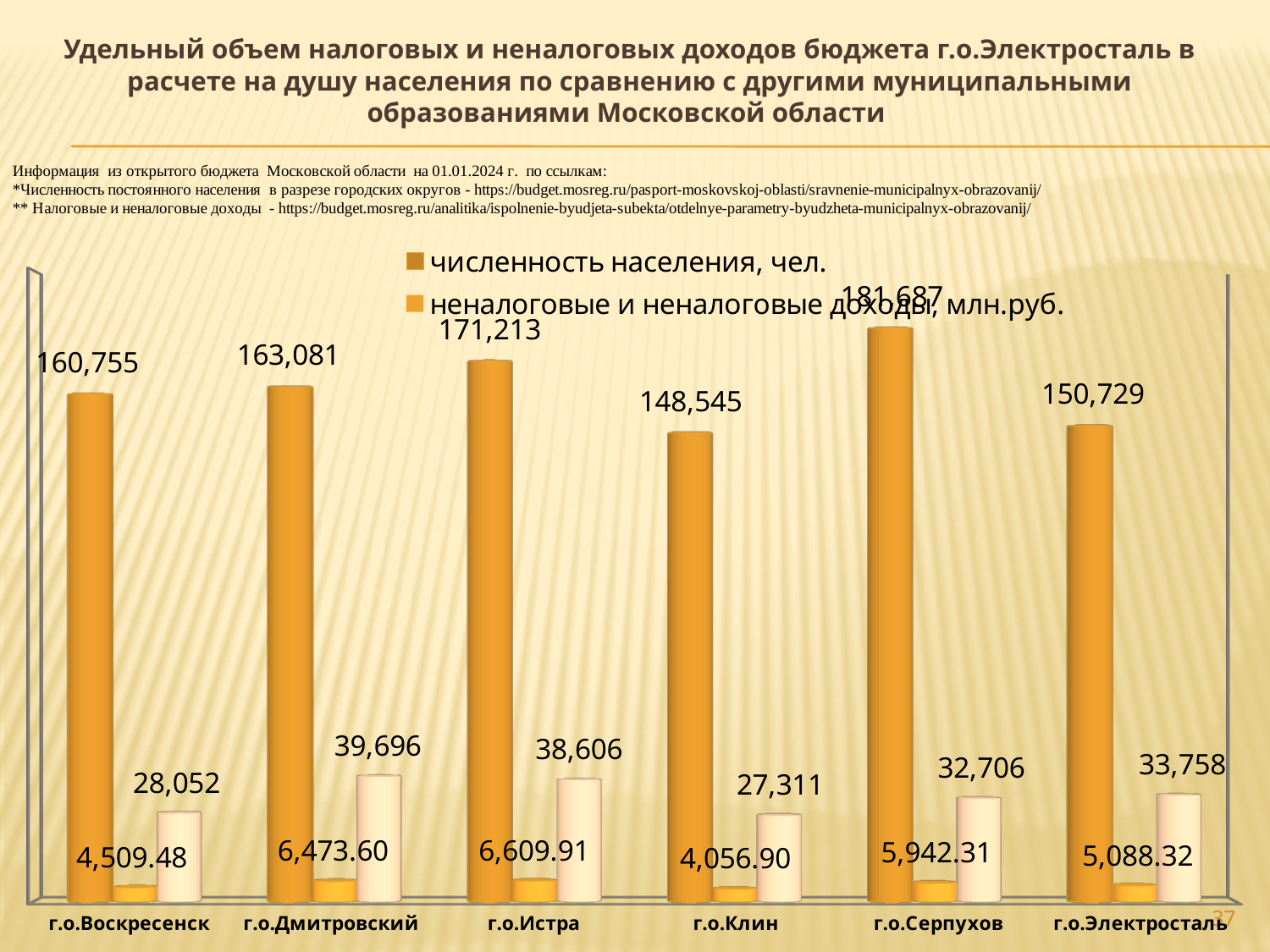
Which has the larger population, г.о.Воскресенск or г.о.Дмитровский? г.о.Дмитровский Which municipality has the lowest population (численность населения)? г.о.Клин What kind of chart is shown on the slide? bar chart What is the population value shown for г.о.Клин? 148,545 What is the population (численность населения, чел.) shown for г.о.Электросталь? 150,729 Which municipality has the lowest value of налоговые и неналоговые доходы, млн.руб.? г.о.Клин How many municipalities are shown on the x axis of the chart? 6 What is the value of налоговые и неналоговые доходы, млн.руб. for г.о.Истра? 6,609.91 What is the difference in налоговые и неналоговые доходы between г.о.Истра and г.о.Клин? 2,553.01 What is the difference in population between г.о.Серпухов and г.о.Клин? 33,142 How many series does the chart legend list? 2 Which municipality has the highest population (численность населения)? г.о.Серпухов